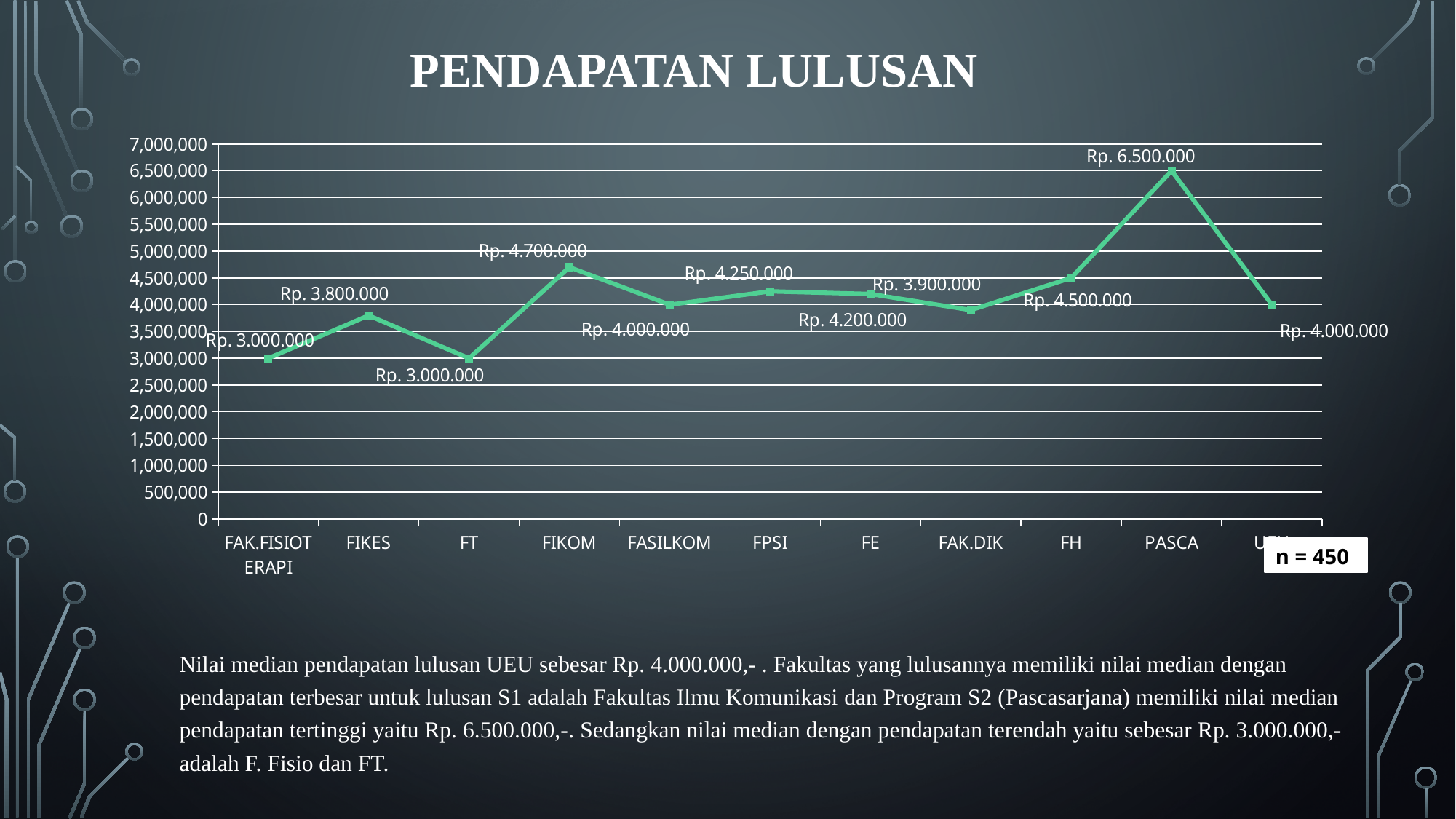
What is the value for FH? Rp. 4.500.000 What type of chart is shown on the slide? line chart Which is larger, the value for FPSI or the value for FE? FPSI What is the value for FIKES? Rp. 3.800.000 Is the value for FAK.DIK greater or less than 4,000,000? less What is the value for FIKOM? Rp. 4.700.000 Which category has the highest value? PASCA Which two categories share the lowest value of Rp. 3.000.000? FAK.FISIOTERAPI and FT What is the value for PASCA? Rp. 6.500.000 How many categories are plotted along the x axis? 11 What is the title of the chart? PENDAPATAN LULUSAN What is the difference between the values for PASCA and FIKOM? Rp. 1.800.000